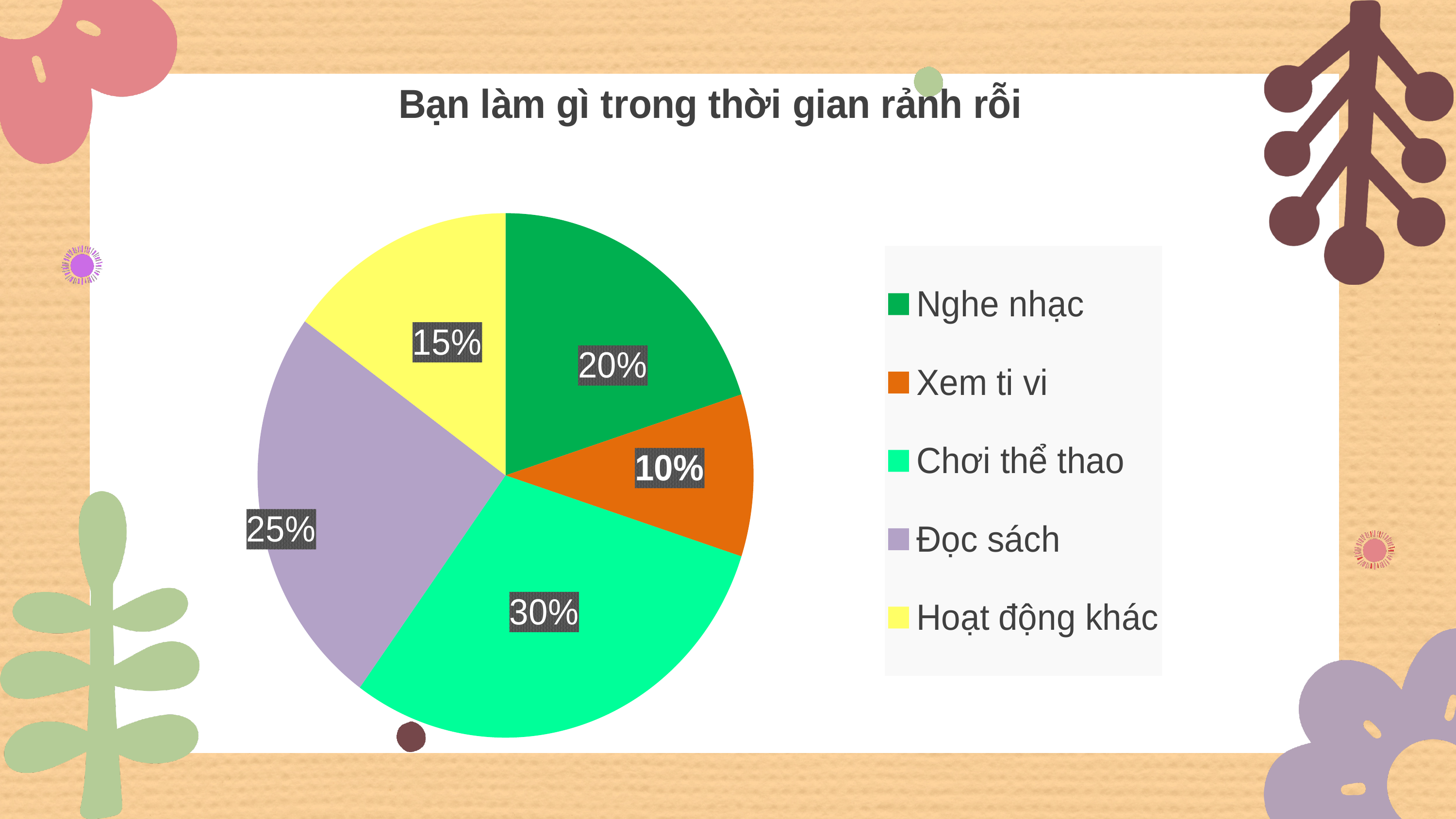
What is the difference between the shares of 'Chơi thể thao' and 'Nghe nhạc'? 10% How many categories does the pie chart have? 5 What percentage of the pie is 'Hoạt động khác'? 15% Which is larger, the share for 'Đọc sách' or the share for 'Hoạt động khác'? Đọc sách What kind of chart is shown on the slide? Pie chart What percentage of the pie is 'Xem ti vi'? 10% Which category has the smallest share of the pie? Xem ti vi What percentage of the pie is 'Đọc sách'? 25% What is the title of the chart? Bạn làm gì trong thời gian rảnh rỗi What percentage of the pie is 'Nghe nhạc'? 20% What percentage of the pie is 'Chơi thể thao'? 30% Which category has the largest share of the pie? Chơi thể thao